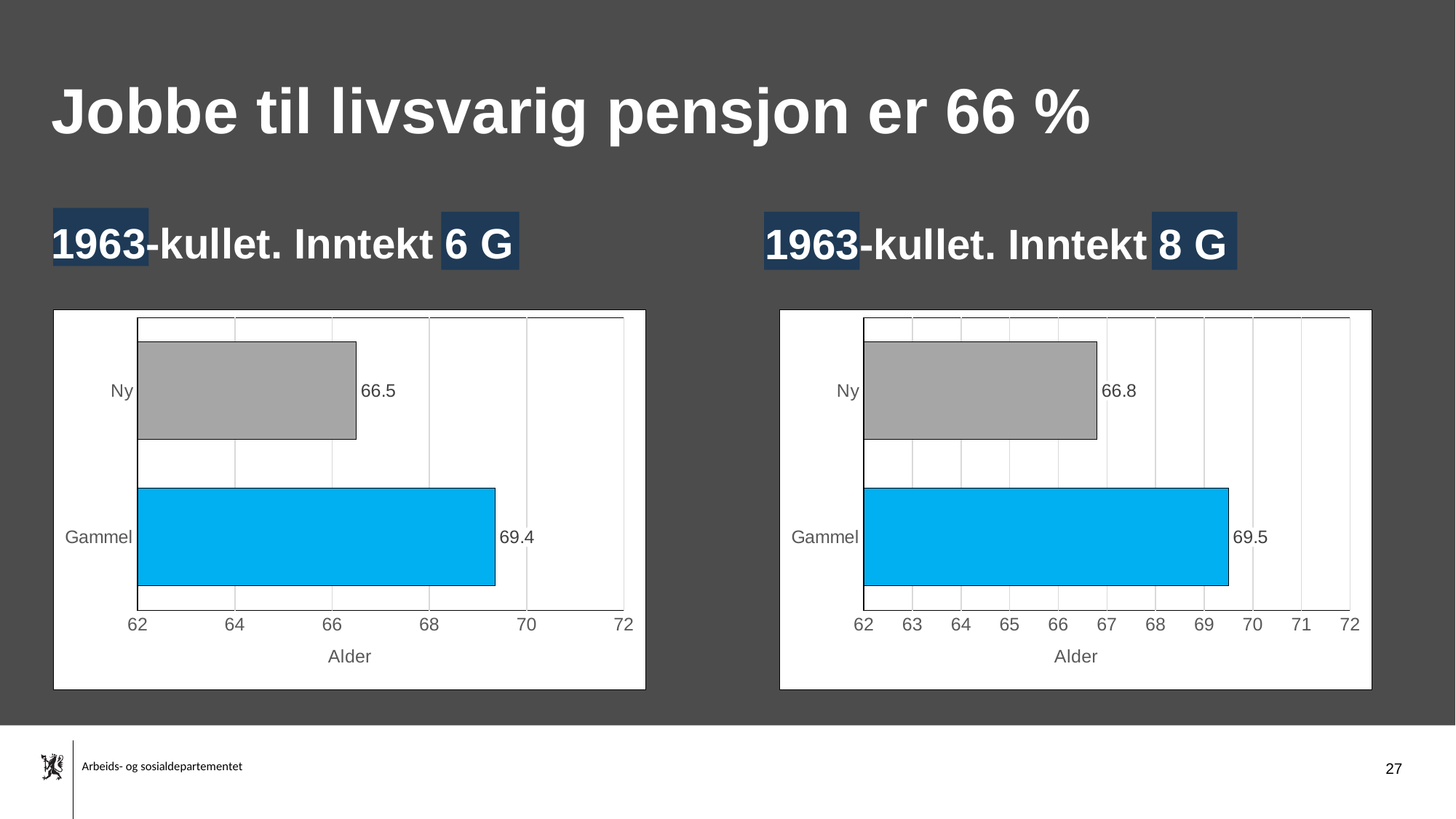
In the right chart (1963-kullet. Inntekt 8 G), which category has the lowest value? Ny In the right chart (1963-kullet. Inntekt 8 G), what is the value for Gammel? 69.5 In the right chart (1963-kullet. Inntekt 8 G), what is the difference between the values for Gammel and Ny? 2.7 How many categories are shown in the left chart (1963-kullet. Inntekt 6 G)? 2 In the right chart (1963-kullet. Inntekt 8 G), what is the value for Ny? 66.8 What kind of chart is the right chart (1963-kullet. Inntekt 8 G)? Bar chart In the left chart (1963-kullet. Inntekt 6 G), which category has the highest value? Gammel In the left chart (1963-kullet. Inntekt 6 G), what is the value for Gammel? 69.4 What is the x-axis label of the left chart (1963-kullet. Inntekt 6 G)? Alder In the left chart (1963-kullet. Inntekt 6 G), what is the difference between the values for Gammel and Ny? 2.9 In the right chart (1963-kullet. Inntekt 8 G), which is larger, the value for Ny or the value for Gammel? Gammel In the left chart (1963-kullet. Inntekt 6 G), what is the value for Ny? 66.5